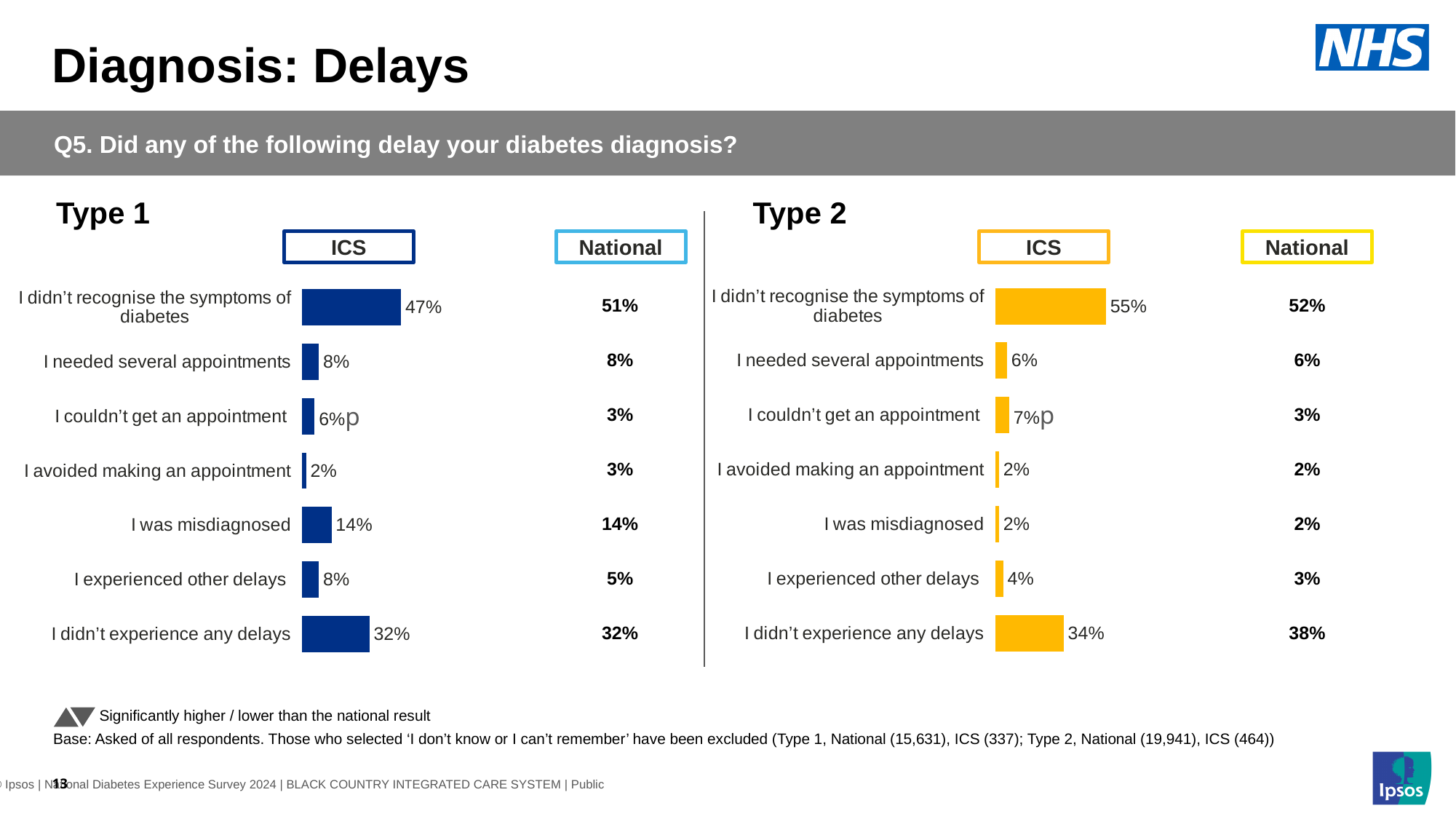
In the Type 1 chart, which category has the lowest ICS value? I avoided making an appointment In the Type 2 chart, which category has the highest ICS value? I didn't recognise the symptoms of diabetes In the Type 1 chart, what is the difference between the National and ICS values for 'I didn't recognise the symptoms of diabetes'? 4% In the Type 2 chart, what is the difference between the National and ICS values for 'I didn't experience any delays'? 4% In the Type 2 chart, what is the ICS value for 'I experienced other delays'? 4% How many categories are shown in the Type 1 chart? 7 In the Type 2 chart, which is larger for 'I didn't recognise the symptoms of diabetes': the ICS value or the National value? ICS In the Type 1 chart, what is the ICS value for 'I was misdiagnosed'? 14% In the Type 1 chart, what is the ICS value for 'I didn't recognise the symptoms of diabetes'? 47% In the Type 1 chart, which is larger for 'I couldn't get an appointment': the ICS value or the National value? ICS In the Type 2 chart, what is the National value for 'I didn't experience any delays'? 38% What type of chart is used for the ICS values in the Type 2 chart? Bar chart